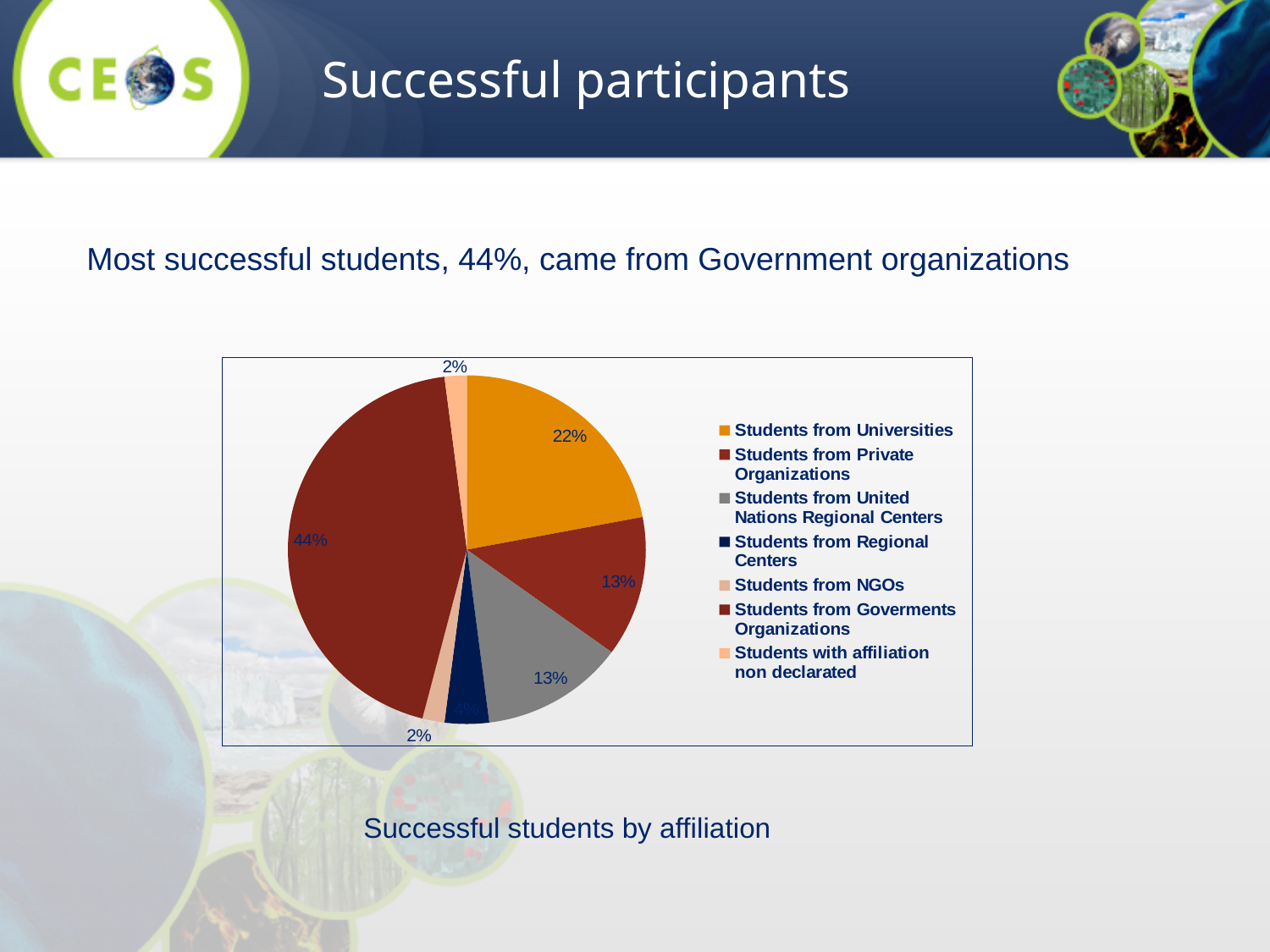
What share of successful students came from NGOs? 2% What share of successful students came from Universities? 22% What is the difference in percentage points between the Government organizations slice and the Universities slice? 22 What share of successful students came from Private Organizations? 13% What is the caption given below the chart? Successful students by affiliation How many categories does the legend list? 7 Which slice is larger: Students from Universities or Students from Private Organizations? Students from Universities What kind of chart is shown on the slide? pie chart What share of successful students came from Government organizations? 44% What share of successful students had an affiliation that was not declared? 2% What share of successful students came from United Nations Regional Centers? 13% Which affiliation has the largest slice of the pie? Students from Goverments Organizations